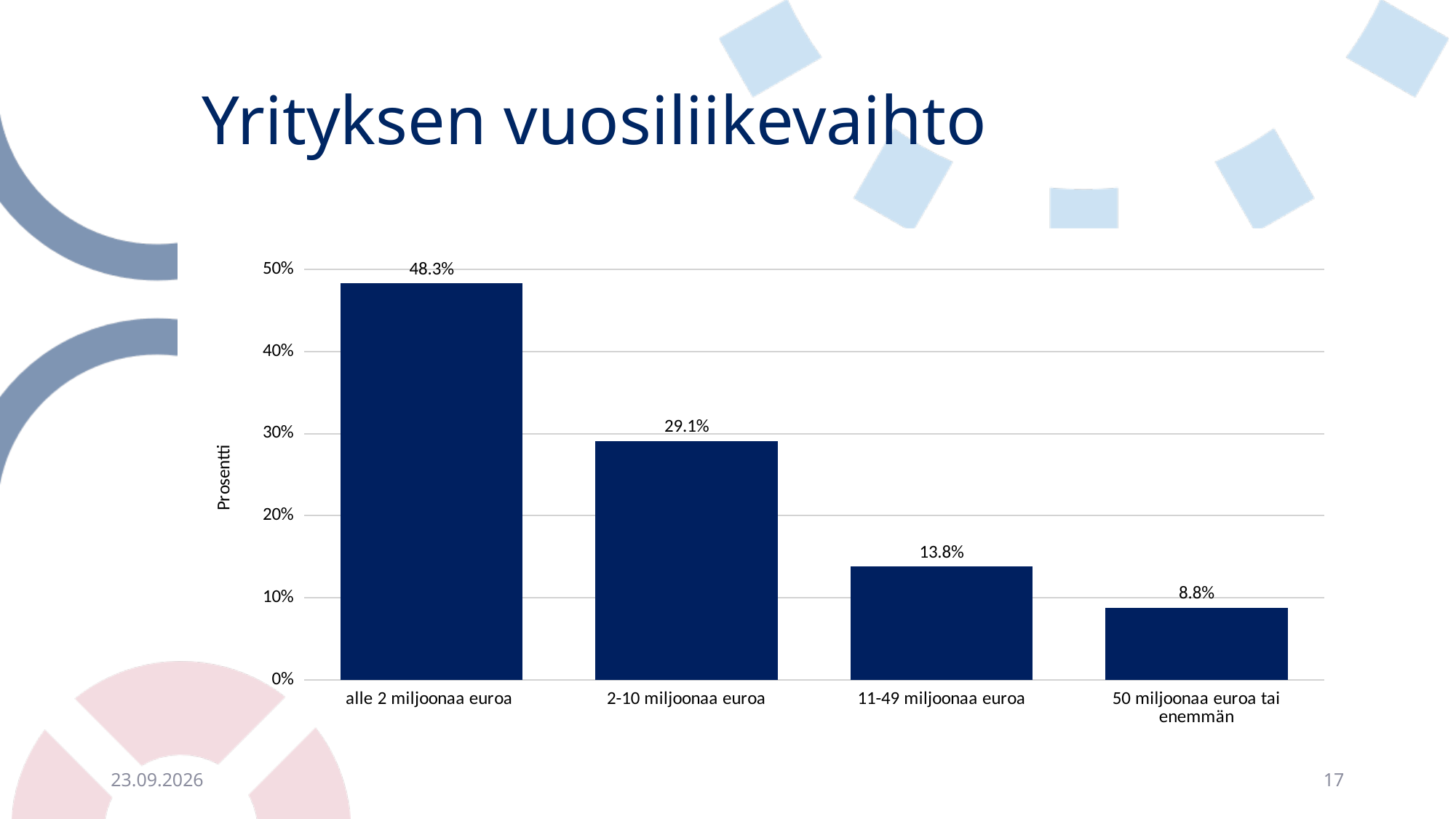
What is the value for '2-10 miljoonaa euroa'? 29.1% Do the values rise or fall from left to right along the x axis? fall Which category has the lowest value? 50 miljoonaa euroa tai enemmän How many categories are shown on the x axis? 4 What is the difference between the values for 'alle 2 miljoonaa euroa' and '2-10 miljoonaa euroa'? 19.2% Which category has the highest value? alle 2 miljoonaa euroa What is the value for 'alle 2 miljoonaa euroa'? 48.3% What kind of chart is shown on the slide? bar chart Is the value for '2-10 miljoonaa euroa' greater or less than 30%? less Which is larger, the value for '11-49 miljoonaa euroa' or '50 miljoonaa euroa tai enemmän'? 11-49 miljoonaa euroa What is the value for '50 miljoonaa euroa tai enemmän'? 8.8% What is the value for '11-49 miljoonaa euroa'? 13.8%